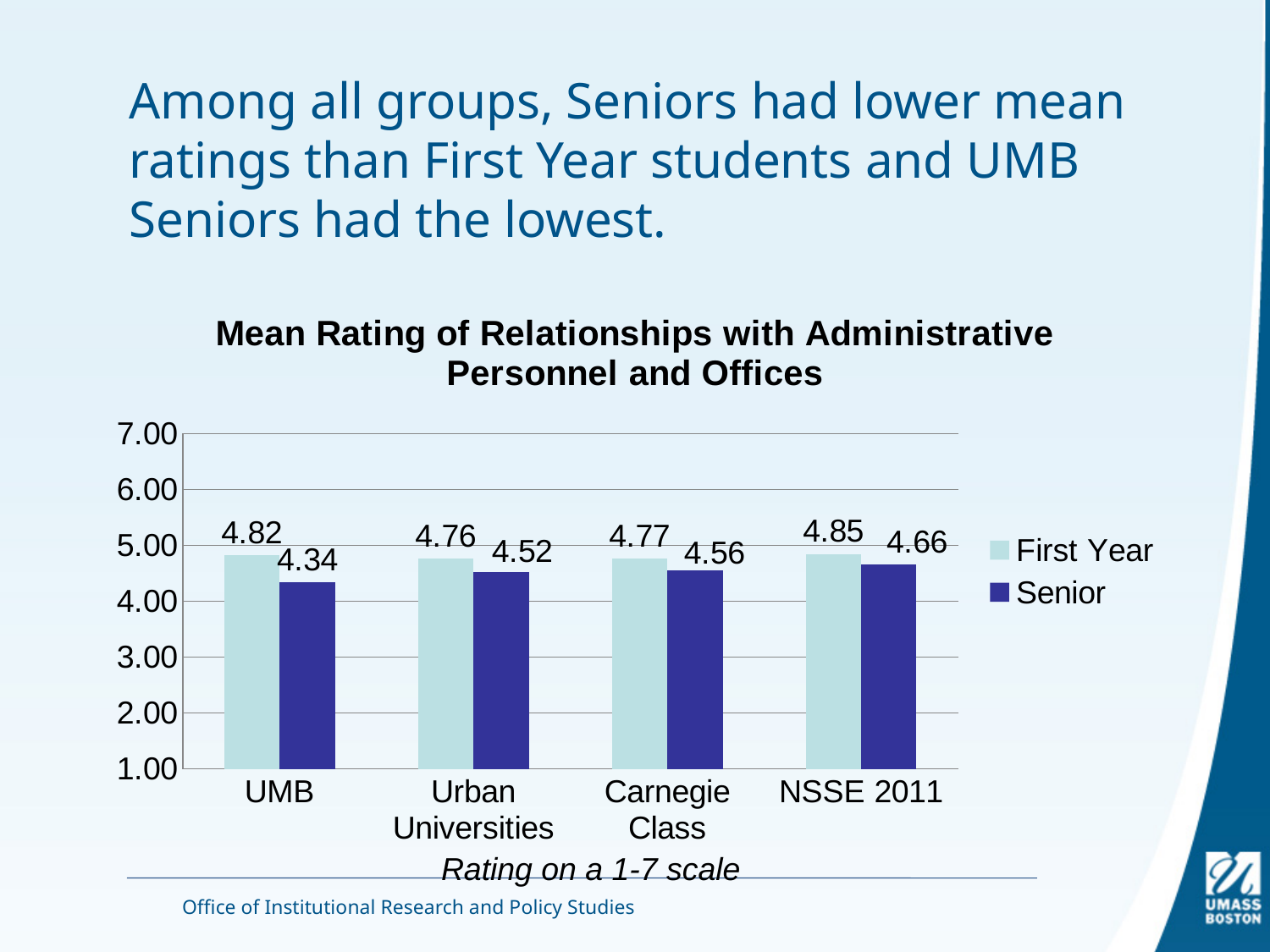
What is the First Year mean rating for UMB? 4.82 Which group has the highest First Year mean rating? NSSE 2011 How many groups are shown on the x axis? 4 What is the Senior mean rating for NSSE 2011? 4.66 What kind of chart is shown on the slide? bar chart What is the Senior mean rating for Carnegie Class? 4.56 What is the difference between the Senior mean ratings for NSSE 2011 and Urban Universities? 0.14 How many series does the legend list? 2 Which is larger, the Senior rating for Urban Universities or the Senior rating for UMB? Urban Universities Which group has the lowest Senior mean rating? UMB What is the difference between the First Year and Senior mean ratings for UMB? 0.48 Is the Senior mean rating for UMB greater or less than 5.00? less